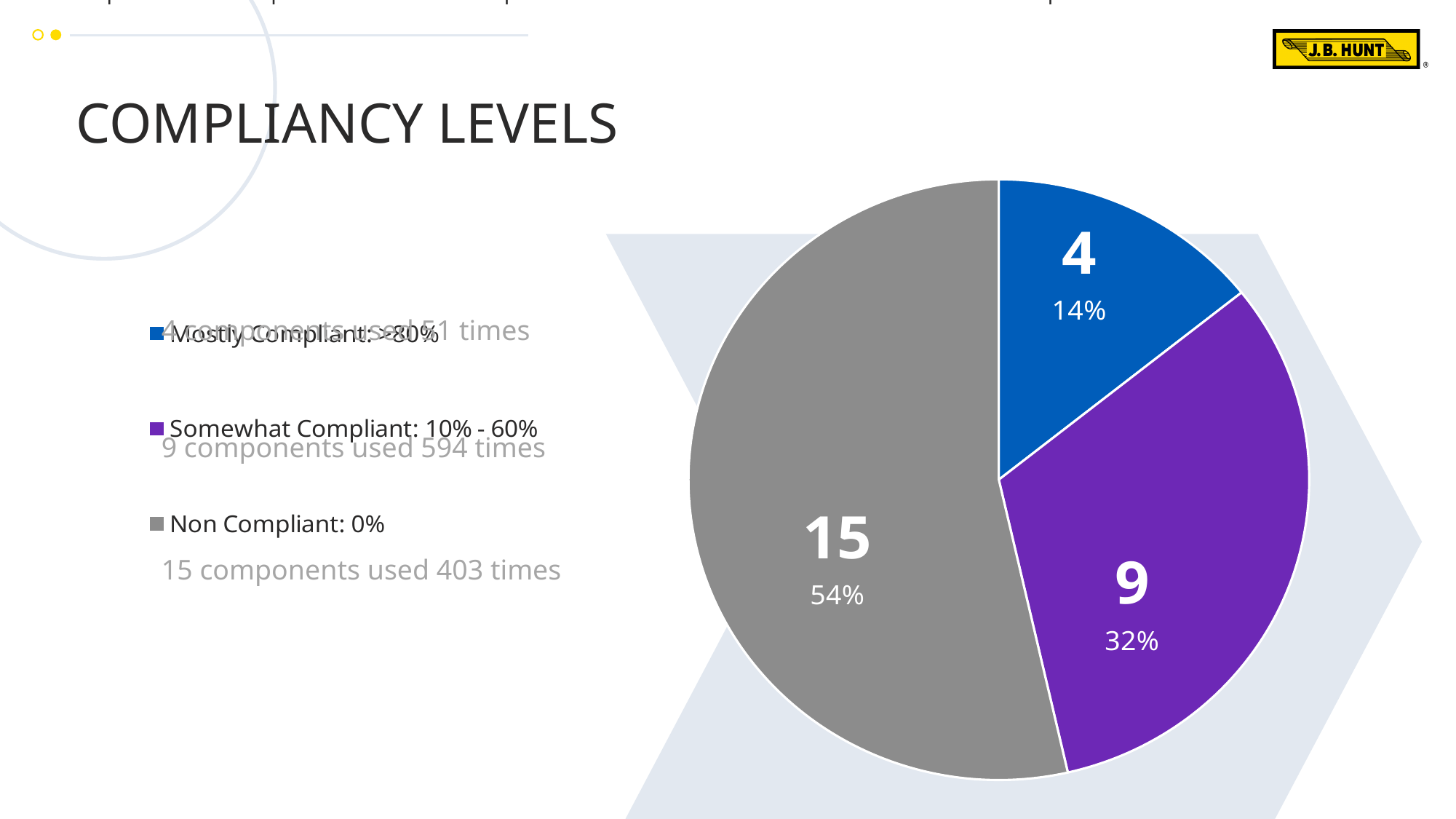
Which category has the largest slice of the pie? Non Compliant: 0% Which colour represents the Somewhat Compliant: 10% - 60% slice? purple What is the value shown for the Mostly Compliant: >80% slice? 4 How many slices does the pie chart have? 3 What is the difference between the values for Non Compliant: 0% and Somewhat Compliant: 10% - 60%? 6 What percentage share of the pie is the Non Compliant: 0% slice? 54% What percentage share of the pie is the Mostly Compliant: >80% slice? 14% What percentage share of the pie is the Somewhat Compliant: 10% - 60% slice? 32% What is the value shown for the Non Compliant: 0% slice? 15 What kind of chart is shown on the slide? pie chart What is the value shown for the Somewhat Compliant: 10% - 60% slice? 9 Which category has the smallest slice of the pie? Mostly Compliant: >80%